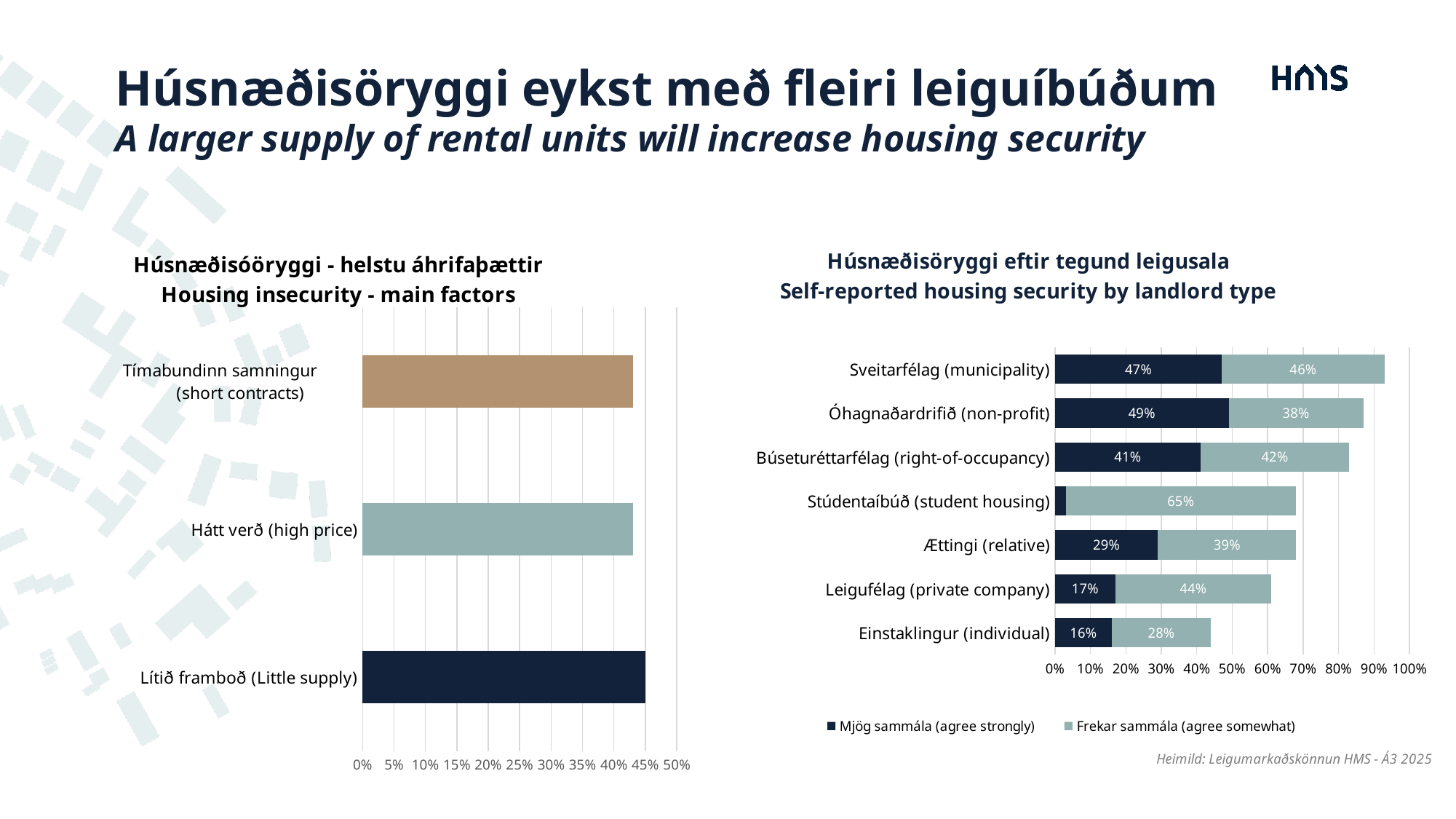
In the 'Self-reported housing security by landlord type' chart, what percentage of municipality tenants agree strongly? 47% In the 'Self-reported housing security by landlord type' chart, how many series does the legend list? 2 In the 'Self-reported housing security by landlord type' chart, which landlord type has the highest 'agree strongly' share? Óhagnaðardrifið (non-profit) In the 'Self-reported housing security by landlord type' chart, what percentage of student housing tenants agree somewhat? 65% What kind of chart is the 'Housing insecurity - main factors' chart? Bar chart In the 'Housing insecurity - main factors' chart, is the value for Lítið framboð (Little supply) greater or less than 40%? greater How many landlord types are shown in the 'Self-reported housing security by landlord type' chart? 7 In the 'Self-reported housing security by landlord type' chart, what is the combined total of 'agree strongly' and 'agree somewhat' for Einstaklingur (individual)? 44% In the 'Self-reported housing security by landlord type' chart, how much higher is the 'agree strongly' share for Ættingi (relative) than for Leigufélag (private company)? 12 percentage points In the 'Self-reported housing security by landlord type' chart, what is the combined total of 'agree strongly' and 'agree somewhat' for Sveitarfélag (municipality)? 93% In the 'Self-reported housing security by landlord type' chart, what is the 'agree somewhat' value for Leigufélag (private company)? 44% In the 'Self-reported housing security by landlord type' chart, which landlord type has the lowest 'agree somewhat' share? Einstaklingur (individual)